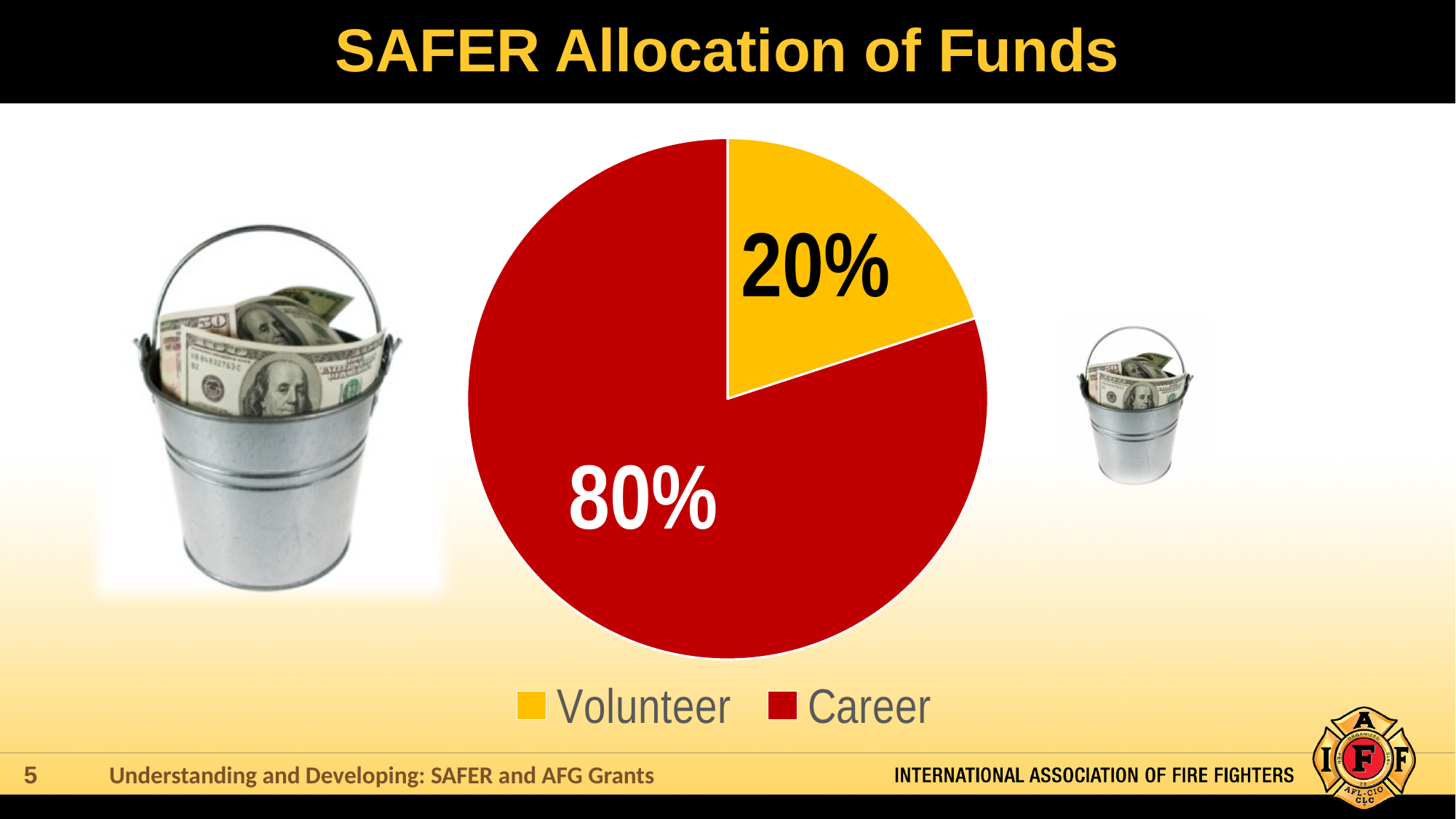
What colour is the Career slice of the pie chart? red What type of chart is shown on the slide? pie chart What share of SAFER funds is allocated to Volunteer? 20% How many entries does the legend list? 2 Which category receives the largest share of funds? Career What is the title of the slide containing the chart? SAFER Allocation of Funds What share of SAFER funds is allocated to Career? 80% How many slices does the pie chart have? 2 What is the share of the pie taken by the Volunteer slice? 20% Which category receives the smallest share of funds? Volunteer What is the difference in percentage points between the Career and Volunteer shares? 60 Which is larger, the Volunteer share or the Career share? Career